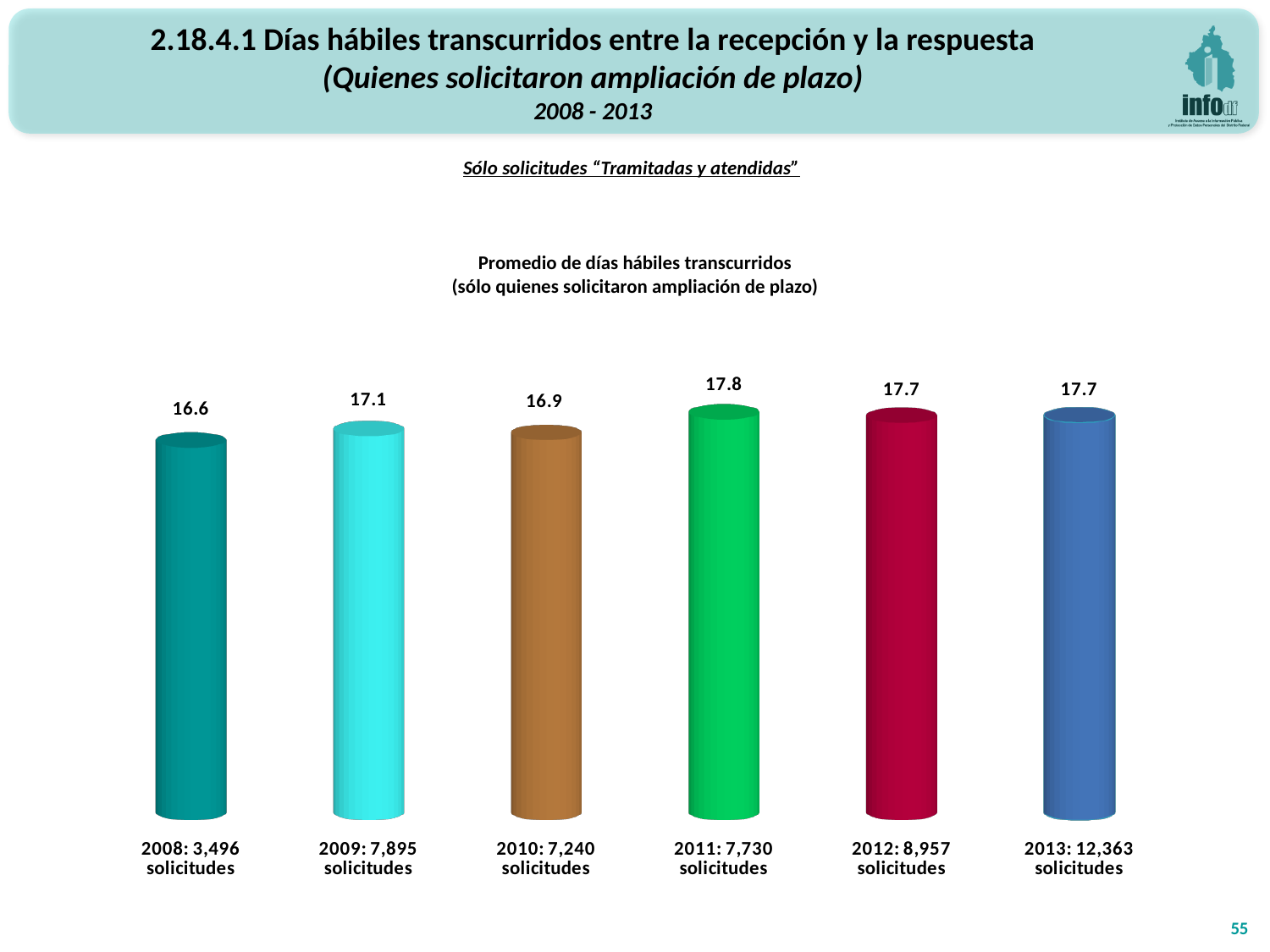
What is the average number of business days elapsed for 2013? 17.7 What is the average number of business days elapsed for 2008? 16.6 How many years (bars) are shown in the chart? 6 Which year has the highest average number of business days elapsed? 2011 What type of chart is shown on the slide? Bar chart How many solicitudes are indicated for 2013 in the category label? 12,363 What is the difference between the average business days for 2011 and 2008? 1.2 What is the title of the chart? Promedio de días hábiles transcurridos (sólo quienes solicitaron ampliación de plazo) What is the average number of business days elapsed for 2011? 17.8 Which year has a higher average of business days elapsed, 2009 or 2010? 2009 What is the difference between the average business days for 2009 and 2010? 0.2 Which year has the lowest average number of business days elapsed? 2008